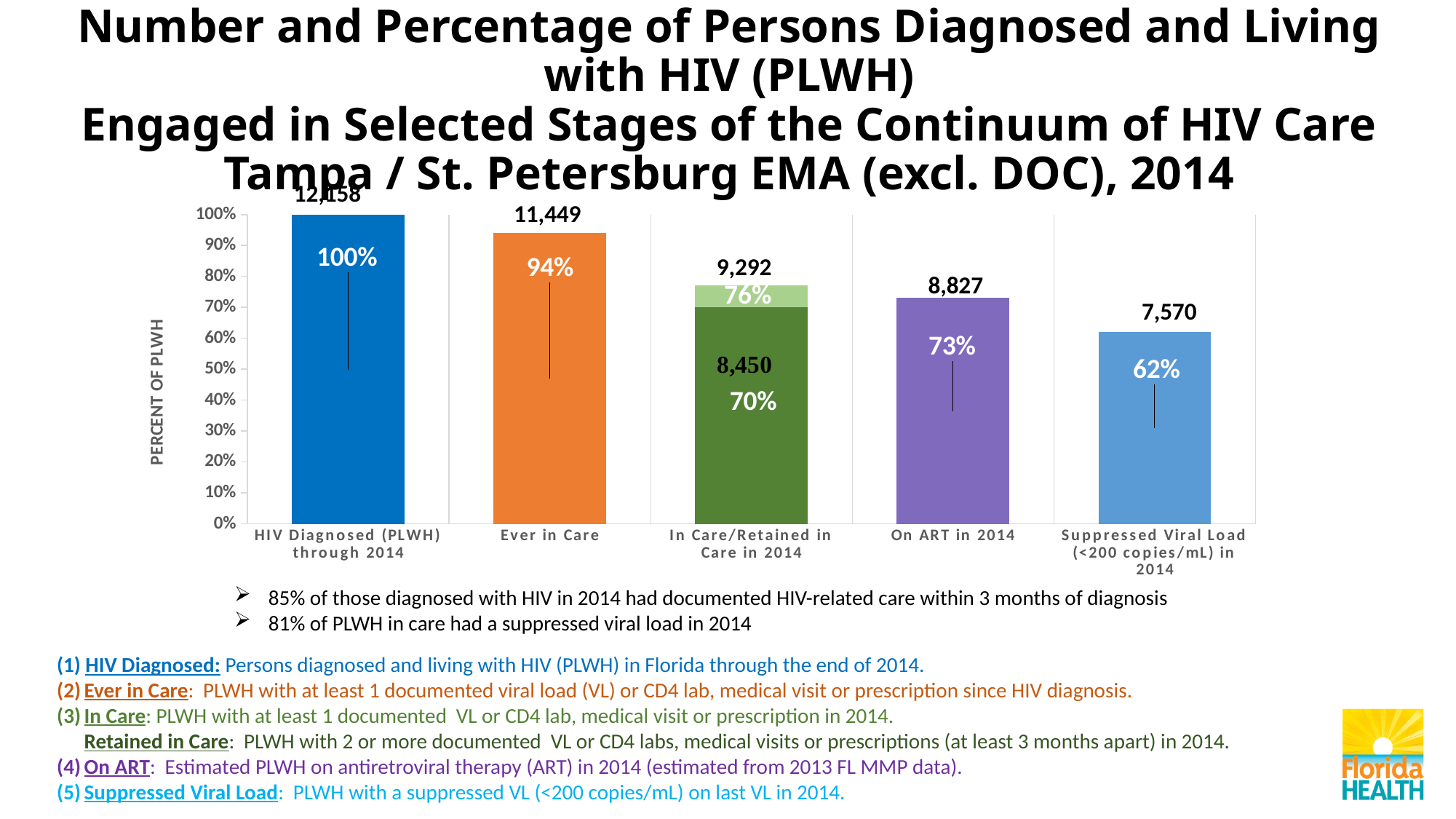
What is the difference in number of persons between 'Ever in Care' (11,449) and 'Suppressed Viral Load' (7,570)? 3,879 What percentage is shown for the 'Ever in Care' bar? 94% What type of chart is shown on the slide? bar chart Which is larger, the percentage for 'On ART in 2014' or the percentage for 'Suppressed Viral Load (<200 copies/mL) in 2014'? On ART in 2014 How many categories are shown on the x axis of the chart? 5 What number is printed above the 'HIV Diagnosed (PLWH) through 2014' bar? 12,158 What number is printed above the 'On ART in 2014' bar? 8,827 What percentage is shown for 'Suppressed Viral Load (<200 copies/mL) in 2014'? 62% Which category has the highest percentage of PLWH? HIV Diagnosed (PLWH) through 2014 Which category has the lowest percentage of PLWH? Suppressed Viral Load (<200 copies/mL) in 2014 What percentage is shown for the 'Retained in Care' (darker green) portion of the 'In Care/Retained in Care in 2014' bar? 70%